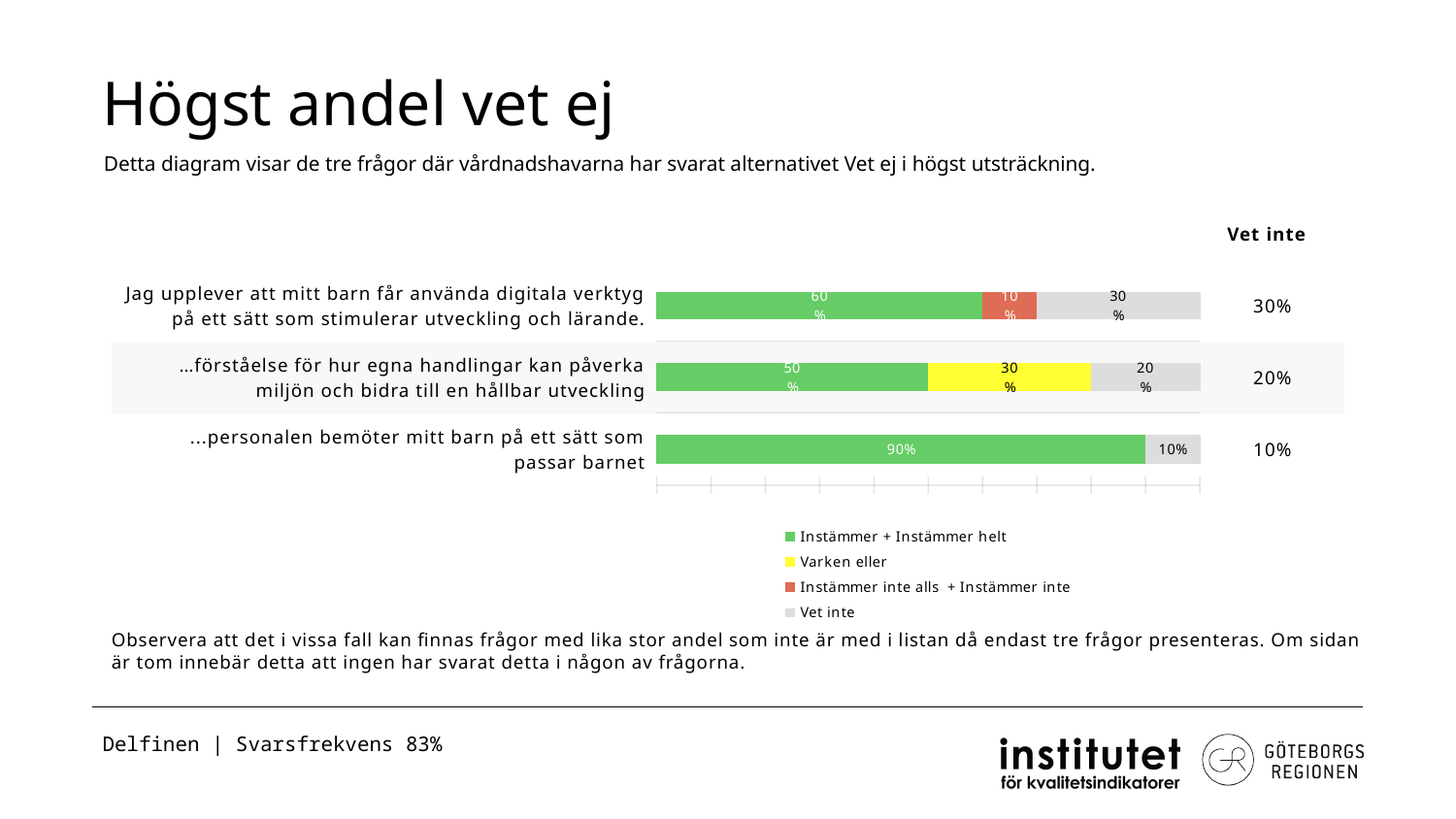
How many questions (categories) are plotted in the chart? 3 What is the title of the slide containing the chart? Högst andel vet ej How many series does the legend list? 4 What kind of chart is shown on the slide? Stacked bar chart What is the 'Varken eller' value for '…förståelse för hur egna handlingar kan påverka miljön och bidra till en hållbar utveckling'? 30% Which is larger: the 'Vet inte' value for 'Jag upplever att mitt barn får använda digitala verktyg...' or for '…förståelse för hur egna handlingar kan påverka miljön...'? Jag upplever att mitt barn får använda digitala verktyg... What is the difference between the 'Instämmer + Instämmer helt' values for '...personalen bemöter mitt barn på ett sätt som passar barnet' and '…förståelse för hur egna handlingar kan påverka miljön och bidra till en hållbar utveckling'? 40% What is the 'Vet inte' value for 'Jag upplever att mitt barn får använda digitala verktyg på ett sätt som stimulerar utveckling och lärande.'? 30% Which question has the highest 'Instämmer + Instämmer helt' share? ...personalen bemöter mitt barn på ett sätt som passar barnet Which question has the lowest 'Vet inte' share? ...personalen bemöter mitt barn på ett sätt som passar barnet What is the 'Instämmer + Instämmer helt' value for '...personalen bemöter mitt barn på ett sätt som passar barnet'? 90% What is the 'Instämmer inte alls + Instämmer inte' value for 'Jag upplever att mitt barn får använda digitala verktyg på ett sätt som stimulerar utveckling och lärande.'? 10%